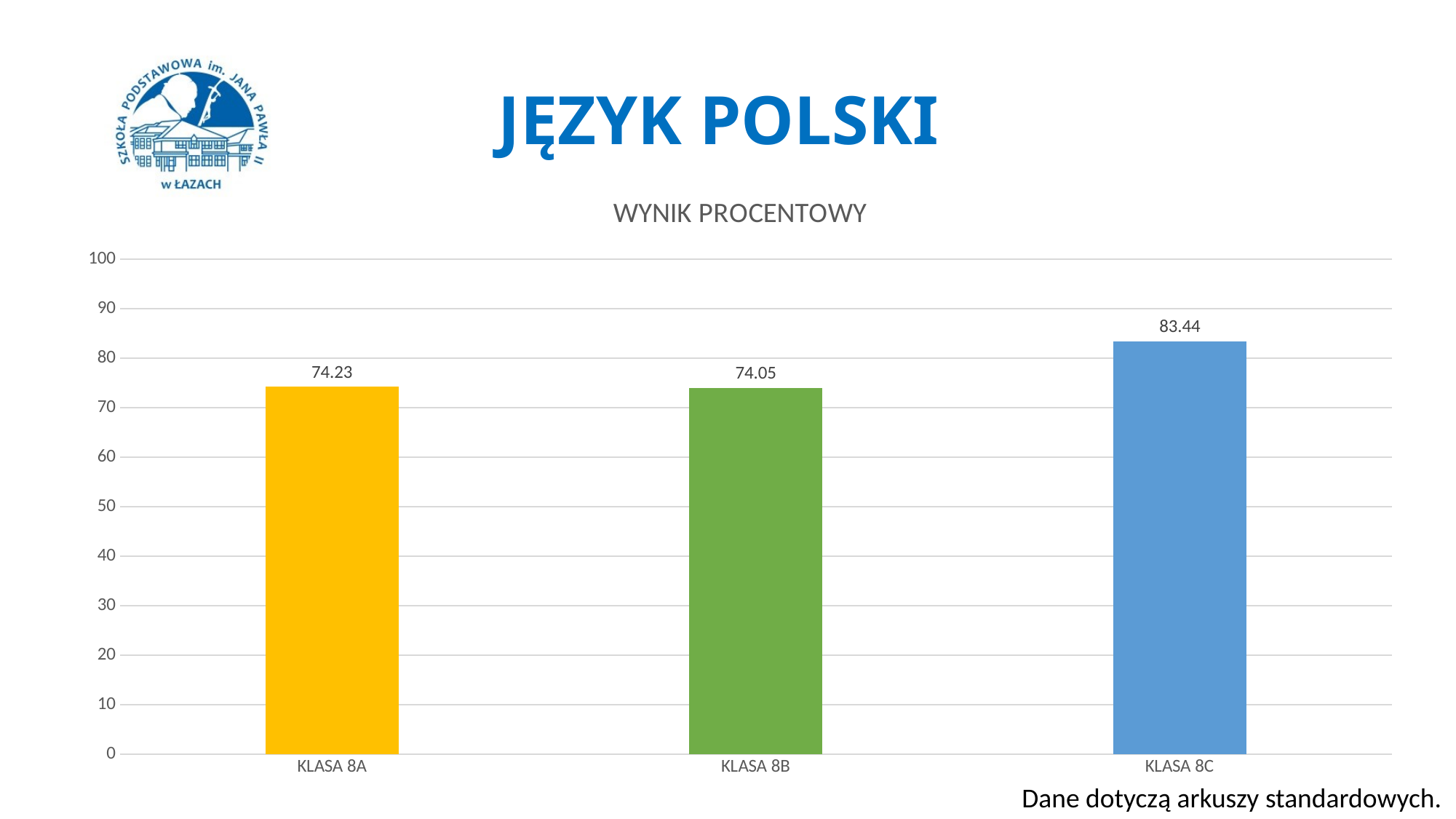
Which class has the lowest value? KLASA 8B Is the value for KLASA 8C greater or less than 80? greater Which class has the highest value? KLASA 8C What is the value for KLASA 8A? 74.23 What is the difference between the values for KLASA 8C and KLASA 8A? 9.21 What is the value for KLASA 8C? 83.44 What kind of chart is shown on the slide? bar chart What is the title of the chart? WYNIK PROCENTOWY How many classes are shown in the chart? 3 What is the difference between the values for KLASA 8C and KLASA 8B? 9.39 Which is larger, the value for KLASA 8C or the value for KLASA 8A? KLASA 8C What is the value for KLASA 8B? 74.05